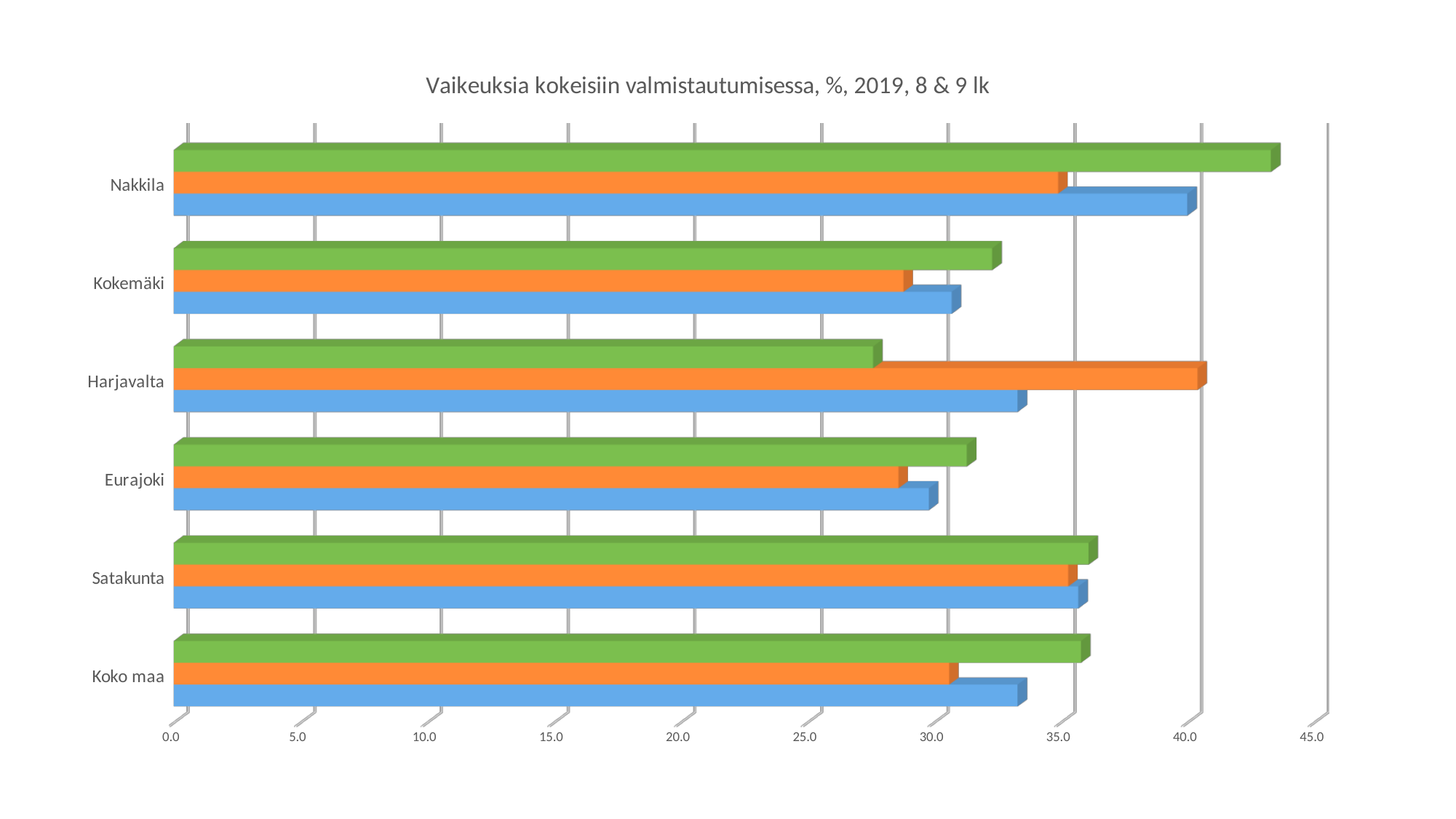
How many categories are shown on the vertical axis of the chart? 6 What kind of chart is shown on the slide? bar chart For Harjavalta, which is larger: the orange bar or the green bar? the orange bar Which category has the longest orange bar? Harjavalta Is the value of the green bar for Harjavalta greater or less than 30.0? less Is the value of the blue bar for Koko maa greater or less than 30.0? greater Is the value of the green bar for Nakkila greater or less than 40.0? greater Which category has the shortest green bar? Harjavalta Which category has the longest green bar? Nakkila How many bars are plotted for each category in the chart? 3 Which category has the longest blue bar? Nakkila What is the title of the chart? Vaikeuksia kokeisiin valmistautumisessa, %, 2019, 8 & 9 lk